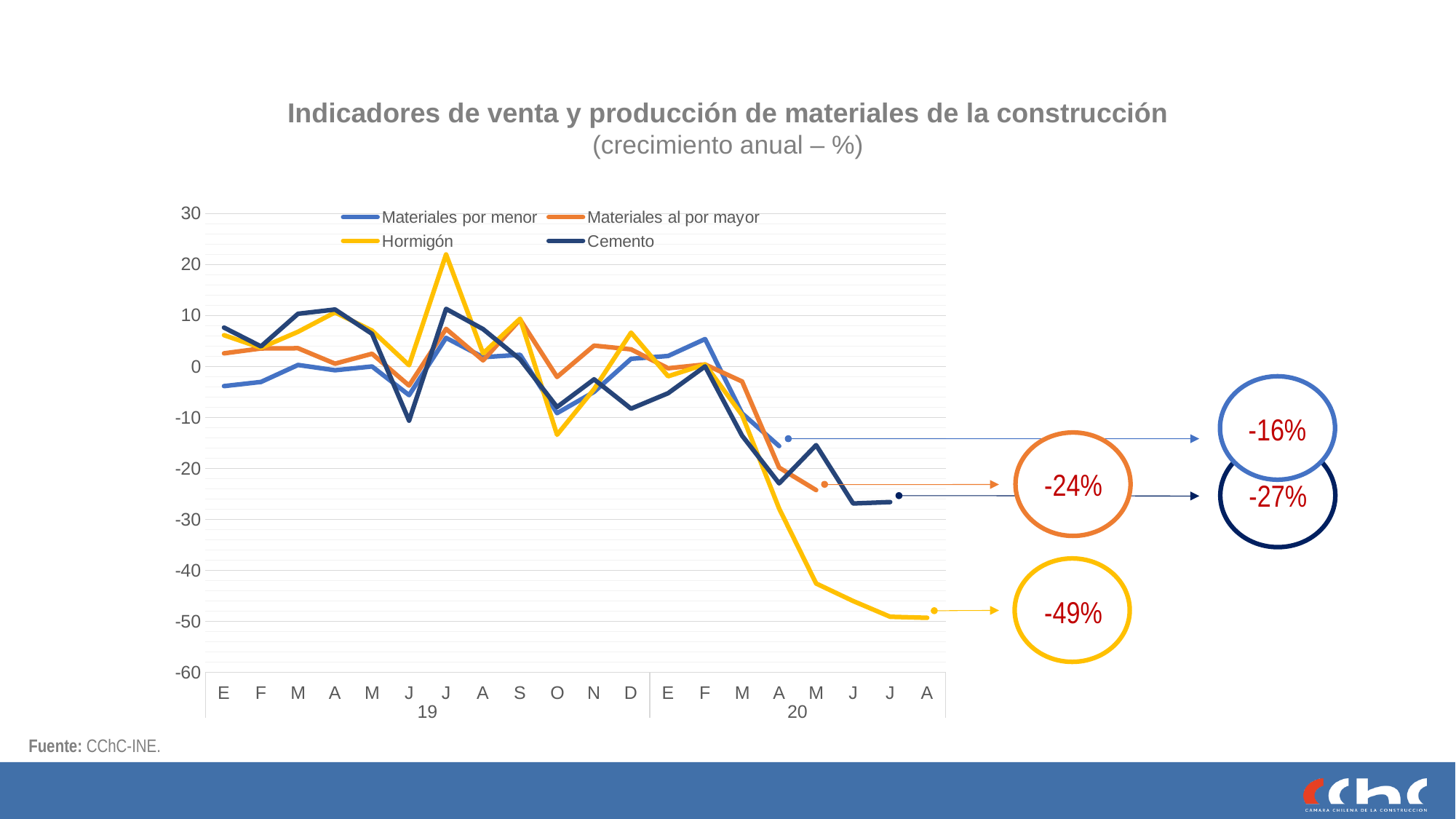
What is the latest value shown in the callout for Hormigón? -49% What is the latest value shown in the callout for Materiales al por mayor? -24% Is the value for Hormigón in July (J) of 2019 greater or less than 10? greater Which has the larger latest callout value, Materiales al por mayor or Cemento? Materiales al por mayor Which series has the lowest latest value according to the callouts? Hormigón Which series has the highest latest value according to the callouts? Materiales por menor How many series does the legend list? 4 What is the latest value shown in the callout for Cemento? -27% Does the Hormigón line rise or fall from February (F) 2020 to August (A) 2020? fall What is the difference between the latest callout values for Cemento and Hormigón? 22 percentage points What is the latest value shown in the callout for Materiales por menor? -16% What type of chart is shown on the slide? line chart